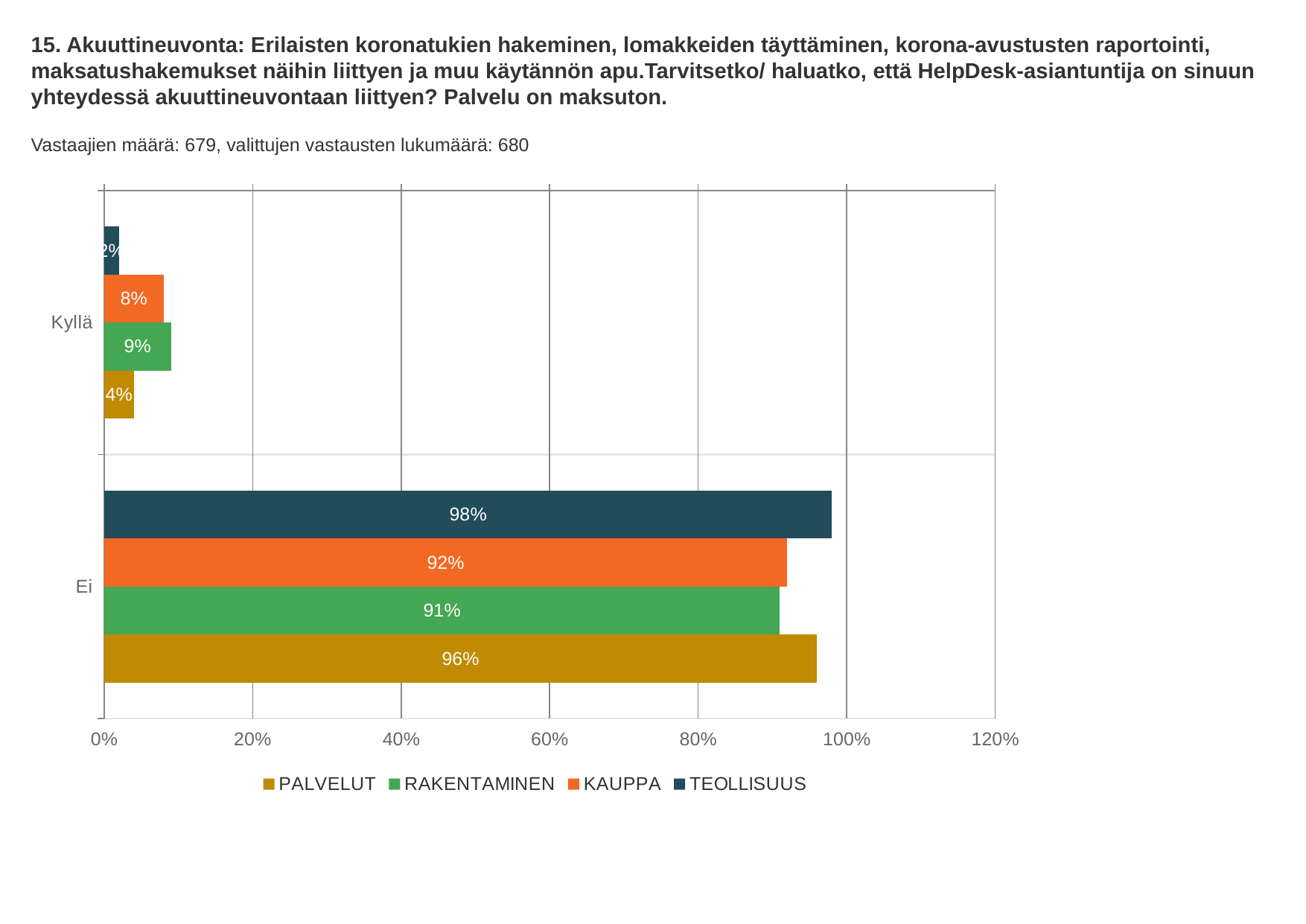
Which series has the highest value in the Ei category? TEOLLISUUS Is the value for TEOLLISUUS in the Kyllä category greater or less than 20%? less How many categories are shown on the vertical axis? 2 How many series does the legend list? 4 What is the value for RAKENTAMINEN in the Kyllä category? 9% Which series has the lowest value in the Ei category? RAKENTAMINEN Which series is shown in orange in the legend? KAUPPA What is the value for KAUPPA in the Kyllä category? 8% What kind of chart is shown on the slide? bar chart What is the value for PALVELUT in the Ei category? 96% What is the value for TEOLLISUUS in the Ei category? 98% What is the difference between the KAUPPA and RAKENTAMINEN values in the Ei category? 1%